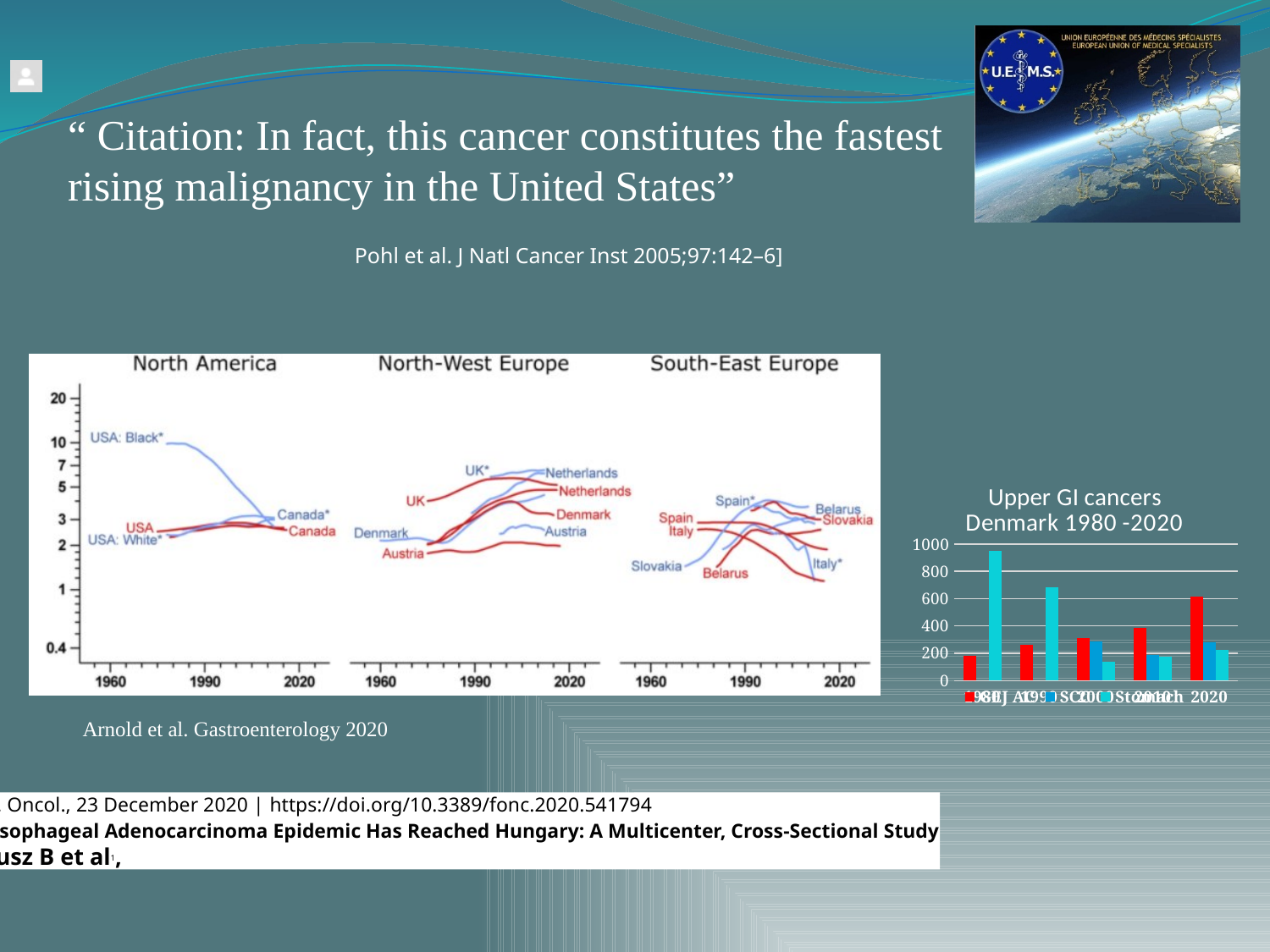
How many regional panels does the Arnold et al. line chart on the left contain? 3 In the 'Upper GI cancers Denmark 1980 -2020' chart, is the red bar for 2020 greater or less than 400? greater In the North America panel of the Arnold et al. line chart, does the 'USA: Black*' line rise or fall over time? fall What kind of chart is the Arnold et al. Gastroenterology 2020 figure on the left of the slide? line chart In the 'Upper GI cancers Denmark 1980 -2020' chart, is the tallest cyan bar (1980) greater or less than 800? greater In the 'Upper GI cancers Denmark 1980 -2020' chart, which is larger in 1980: the red bar or the cyan bar? the cyan bar What is the highest value shown on the y axis of the 'Upper GI cancers Denmark 1980 -2020' chart? 1000 In the 'Upper GI cancers Denmark 1980 -2020' chart, is the red bar for 1980 greater or less than 400? less What kind of chart is the 'Upper GI cancers Denmark 1980 -2020' chart? bar chart In the 'Upper GI cancers Denmark 1980 -2020' chart, do the red bars generally rise or fall from 1980 to 2020? rise In the 'Upper GI cancers Denmark 1980 -2020' chart, in which year is the cyan series highest? 1980 How many year categories are shown on the x axis of the 'Upper GI cancers Denmark 1980 -2020' chart? 5